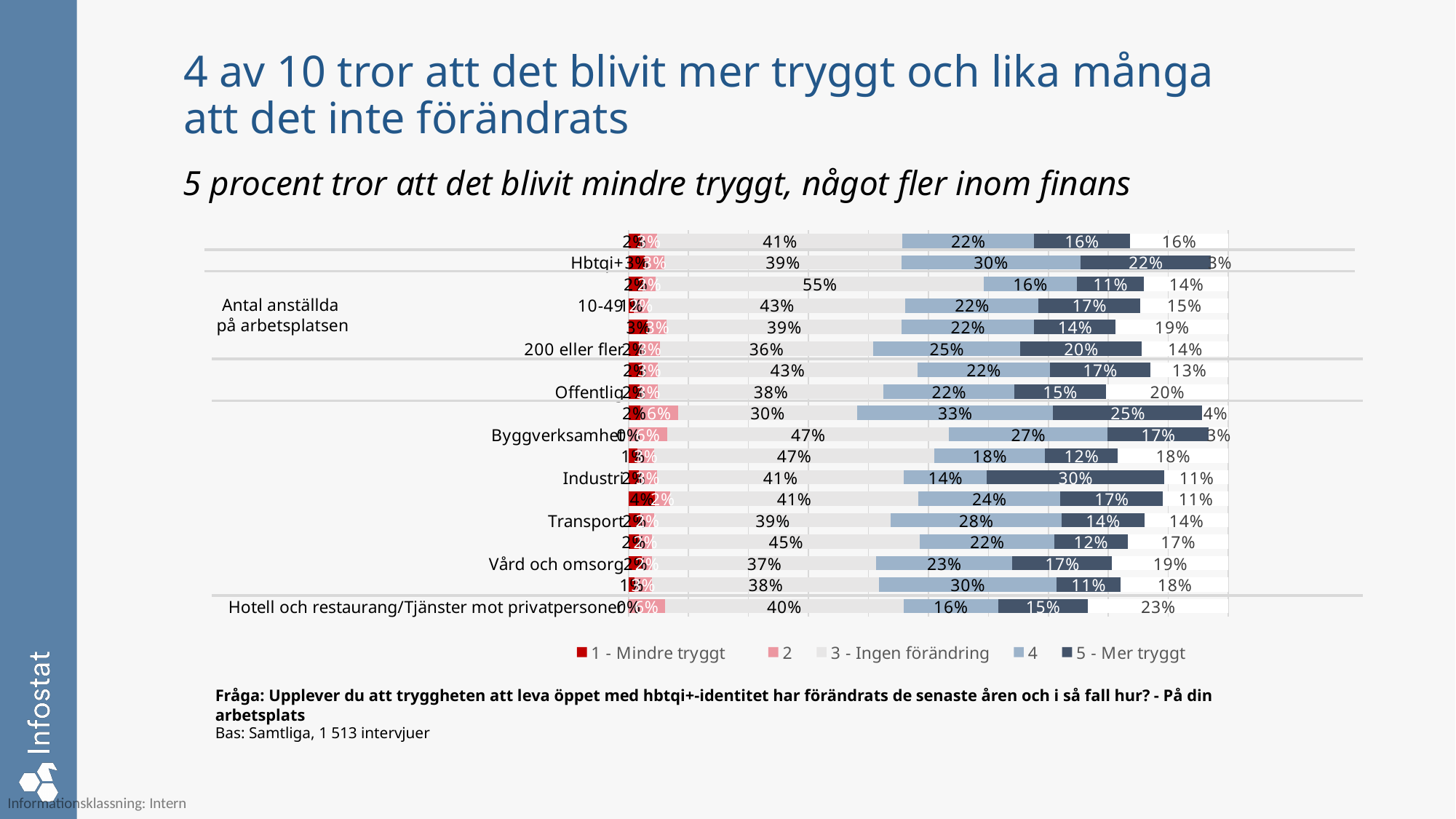
What is the value of '3 - Ingen förändring' for '200 eller fler'? 36% What kind of chart is shown on the slide? Stacked bar chart What is the value of '5 - Mer tryggt' for 'Industri'? 30% How many series does the legend list? 5 What is the first entry in the chart's legend? 1 - Mindre tryggt Which is larger: the '5 - Mer tryggt' value for 'Industri' or for 'Transport'? Industri What is the value of '5 - Mer tryggt' for 'Offentlig'? 15% What is the difference between the '3 - Ingen förändring' values for '10-49' and '200 eller fler'? 7 percentage points What is the value of '3 - Ingen förändring' for the category '10-49'? 43% Which category has the highest '5 - Mer tryggt' value? Industri What is the value of series '4' for 'Transport'? 28% What is the value of series '4' for 'Hotell och restaurang/Tjänster mot privatpersoner'? 16%